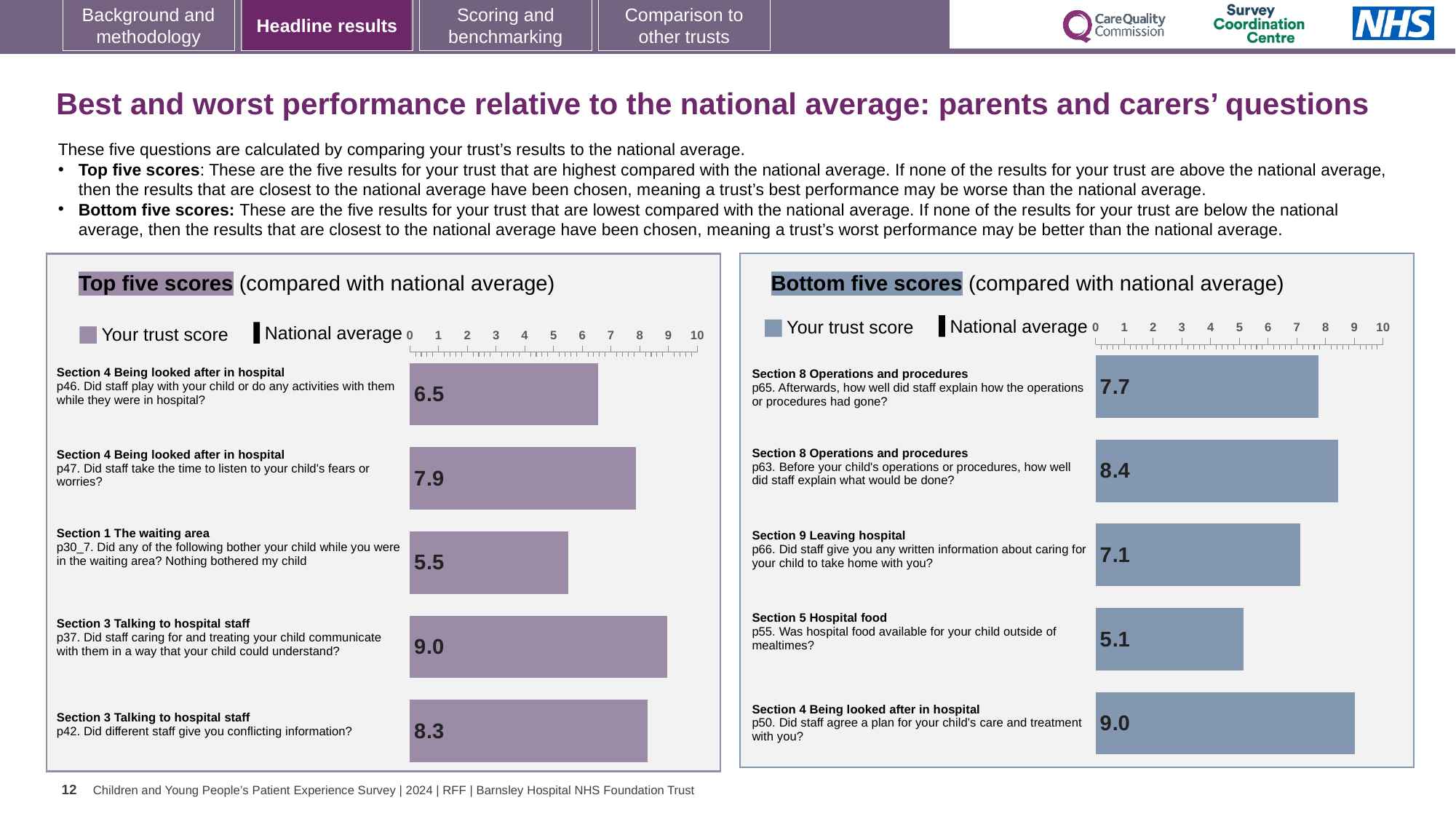
In the Bottom five scores chart, what is the difference between the trust scores for p63 and p66? 1.3 What type of chart is used in the Top five scores panel? Bar chart In the Top five scores chart, how many questions are plotted? 5 In the Top five scores chart, which question has the lowest trust score? p30_7. Did any of the following bother your child while you were in the waiting area? Nothing bothered my child In the Bottom five scores chart, which question has the highest trust score? p50. Did staff agree a plan for your child's care and treatment with you? In the Bottom five scores chart, which question has the lowest trust score? p55. Was hospital food available for your child outside of mealtimes? In the Bottom five scores chart, what is the trust score for p55 (Was hospital food available for your child outside of mealtimes)? 5.1 In the Bottom five scores chart, is the trust score for p63 larger or smaller than the trust score for p65? larger In the Top five scores chart, what is the difference between the trust scores for p37 and p30_7? 3.5 In the Top five scores chart, what is the trust score for p46 (Did staff play with your child or do any activities with them while they were in hospital)? 6.5 In the Top five scores chart, which question has the highest trust score? p37. Did staff caring for and treating your child communicate with them in a way that your child could understand? How many entries does the legend of the Bottom five scores chart list? 2